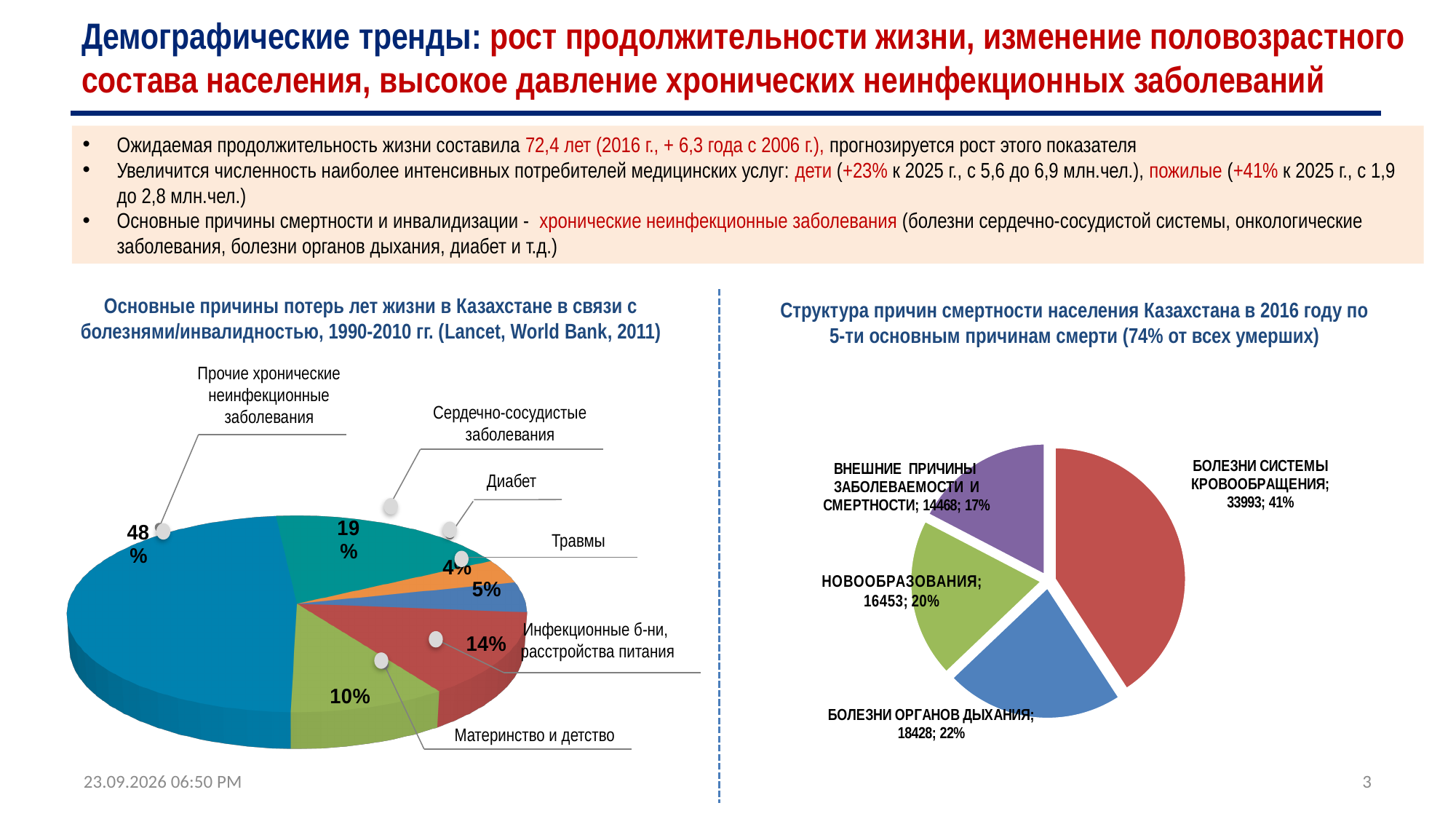
On the right chart (Структура причин смертности населения Казахстана в 2016 году), how many causes of death are shown in the pie? 4 What type of chart is the left chart (Основные причины потерь лет жизни в Казахстане)? Pie chart On the left chart (Основные причины потерь лет жизни в Казахстане), which is larger: Травмы or Диабет? Травмы On the left chart (Основные причины потерь лет жизни в Казахстане), what share is shown for Прочие хронические неинфекционные заболевания? 48% On the right chart (Структура причин смертности населения Казахстана в 2016 году), what value is shown for Болезни системы кровообращения? 33993; 41% On the left chart (Основные причины потерь лет жизни в Казахстане), which category has the smallest share? Диабет On the left chart (Основные причины потерь лет жизни в Казахстане), what share is shown for Материнство и детство? 10% On the right chart (Структура причин смертности населения Казахстана в 2016 году), which cause has the largest share? Болезни системы кровообращения On the right chart (Структура причин смертности населения Казахстана в 2016 году), what value is shown for Новообразования? 16453; 20% On the right chart (Структура причин смертности населения Казахстана в 2016 году), what is the difference in number of deaths between Болезни органов дыхания and Внешние причины заболеваемости и смертности? 3960 On the left chart (Основные причины потерь лет жизни в Казахстане), how many categories are shown in the pie? 6 On the left chart (Основные причины потерь лет жизни в Казахстане), what share is shown for Сердечно-сосудистые заболевания? 19%